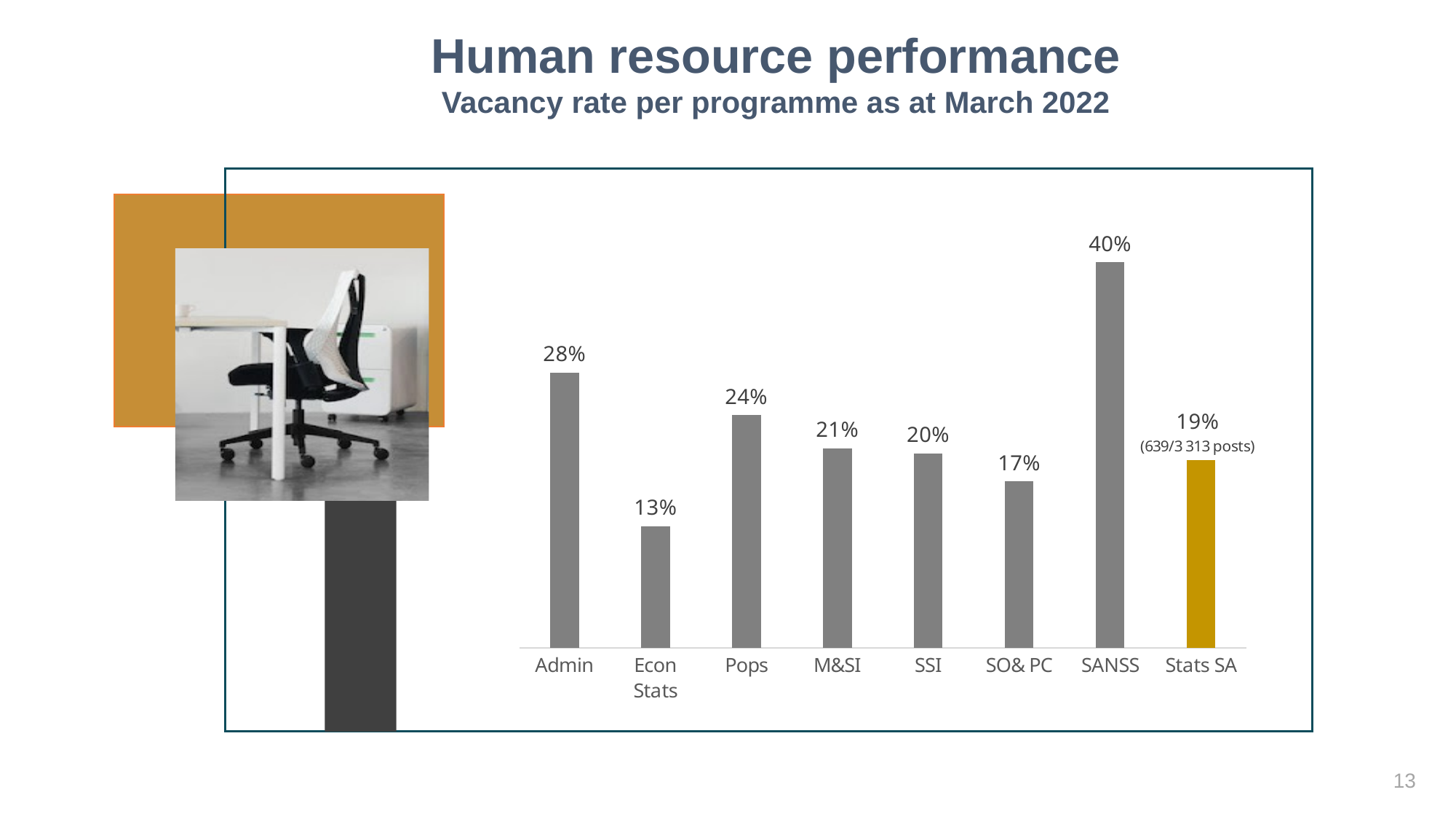
What is the vacancy rate for Econ Stats? 13% What is the difference between the vacancy rates of SANSS and Econ Stats? 27% Which bar is shown in a different colour (gold) from the others? Stats SA What is the difference between the vacancy rates of Admin and SO& PC? 11% What is the vacancy rate for SANSS? 40% Which has a higher vacancy rate, Pops or M&SI? Pops Which programme has the highest vacancy rate? SANSS What is the vacancy rate for Admin? 28% What kind of chart is shown on the slide? Bar chart Which programme has the lowest vacancy rate? Econ Stats How many bars are shown in the chart? 8 What is the vacancy rate for Stats SA overall? 19%